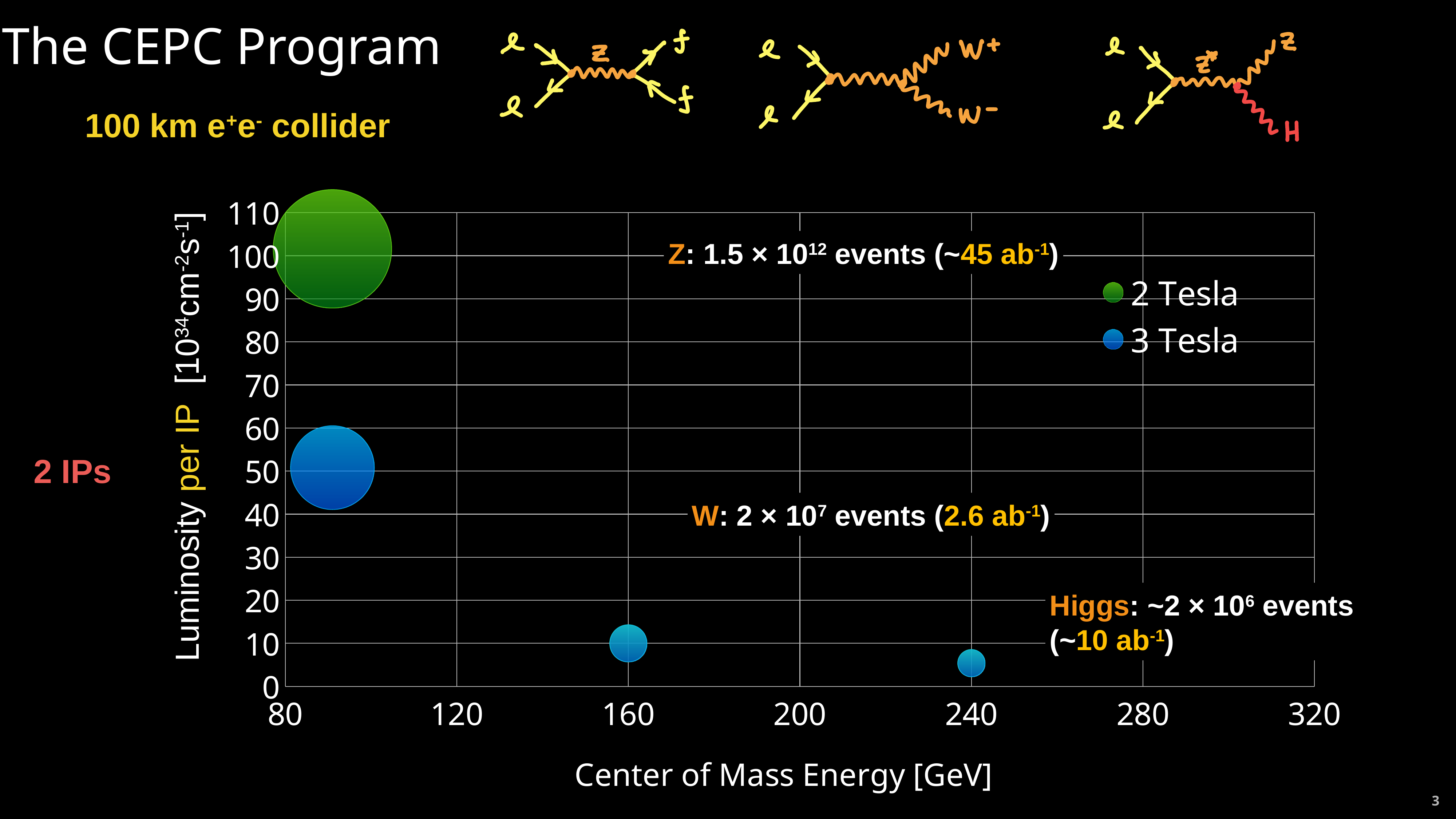
What are the two entries in the chart legend? 2 Tesla and 3 Tesla What is the label of the x axis of the chart? Center of Mass Energy [GeV] Is the luminosity per IP of the 3 Tesla bubble at 160 GeV greater or less than 20? less Which series has the bubble with the highest luminosity per IP? 2 Tesla At which center of mass energy is the bubble with the lowest luminosity per IP located? 240 GeV Is the luminosity per IP of the 2 Tesla (green) bubble greater or less than 90? greater How many bubbles are plotted on the chart? 4 Is the luminosity per IP of the 3 Tesla bubble at 240 GeV greater or less than 10? less At the lowest center of mass energy (around 90 GeV), which series has the higher luminosity per IP, 2 Tesla or 3 Tesla? 2 Tesla What kind of chart is shown on the slide? bubble chart For the 3 Tesla series, does luminosity per IP rise or fall as center of mass energy increases? fall How many series does the chart legend list? 2